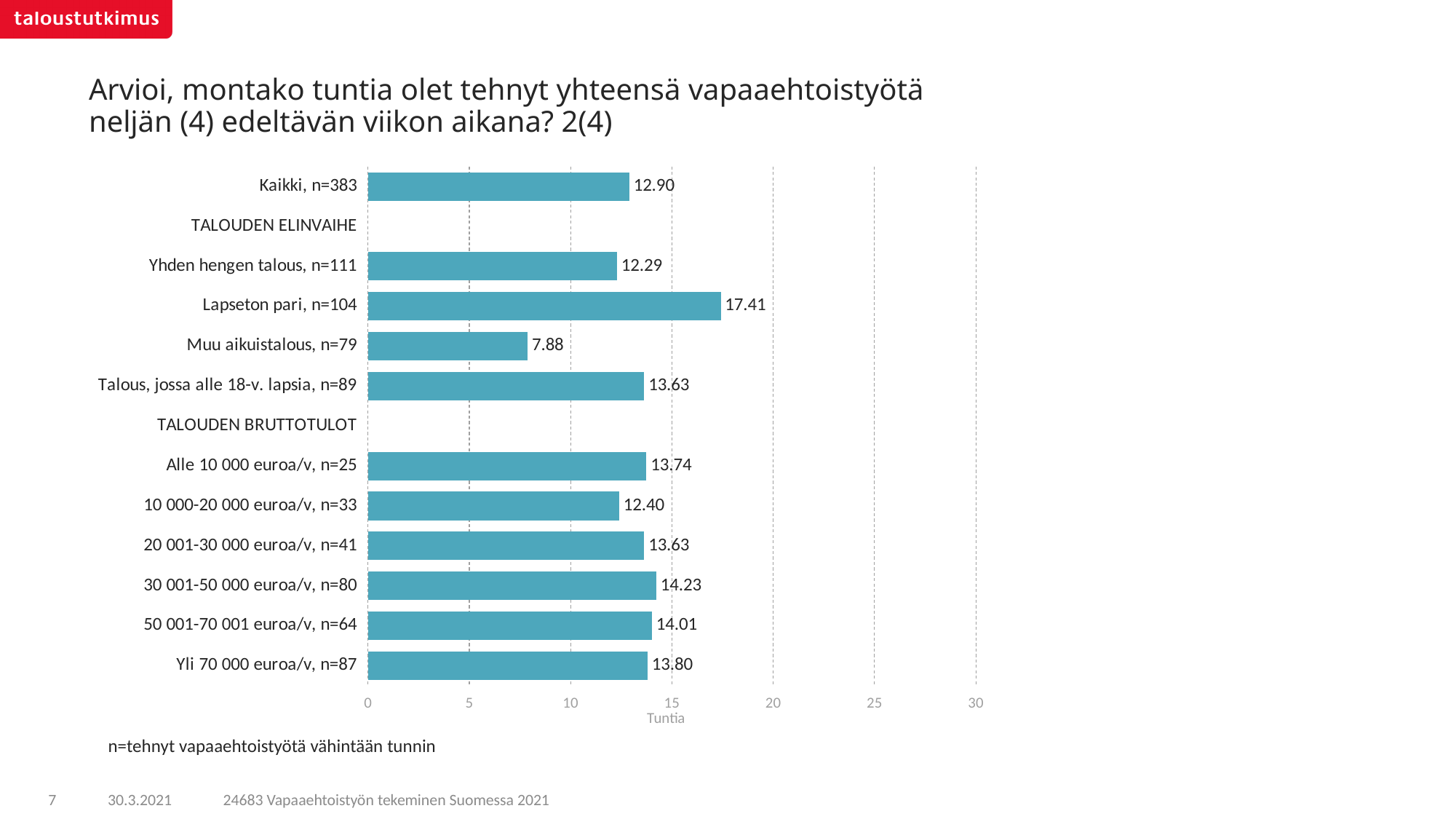
What is the difference between the values for 30 001-50 000 euroa/v, n=80 and Kaikki, n=383? 1.33 What is the value for Kaikki, n=383? 12.90 How many bars are plotted in the chart? 11 Is the value for Muu aikuistalous, n=79 greater or less than 10? less What kind of chart is shown on the slide? bar chart What is the value for Muu aikuistalous, n=79? 7.88 What is the value for 30 001-50 000 euroa/v, n=80? 14.23 What is the value for Lapseton pari, n=104? 17.41 What is the difference between the values for Lapseton pari, n=104 and Muu aikuistalous, n=79? 9.53 Which is larger, the value for Yhden hengen talous, n=111 or the value for Talous, jossa alle 18-v. lapsia, n=89? Talous, jossa alle 18-v. lapsia, n=89 Which category has the highest value? Lapseton pari, n=104 Which category has the lowest value? Muu aikuistalous, n=79